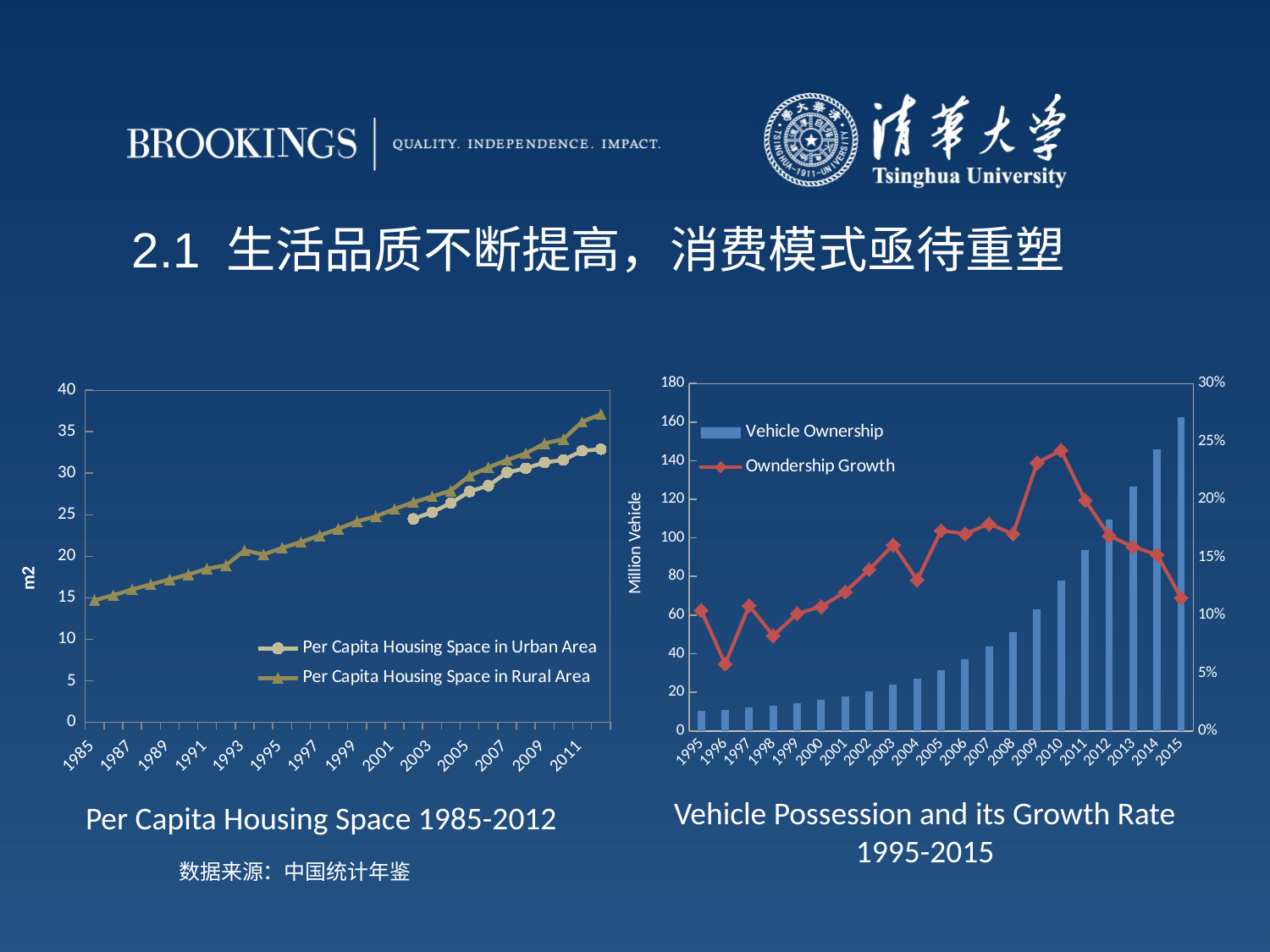
On the left chart, Per Capita Housing Space 1985-2012, how many series does the legend list? 2 On the right chart, Vehicle Possession and its Growth Rate 1995-2015, is the Vehicle Ownership value for 2015 greater or less than 140? greater On the left chart, Per Capita Housing Space 1985-2012, what unit is shown on the y axis? m2 On the right chart, Vehicle Possession and its Growth Rate 1995-2015, in which year is Ownership Growth lowest? 1996 On the right chart, Vehicle Possession and its Growth Rate 1995-2015, in which year is Ownership Growth highest? 2010 On the right chart, Vehicle Possession and its Growth Rate 1995-2015, how many series does the legend list? 2 On the left chart, Per Capita Housing Space 1985-2012, does the rural housing space rise or fall from 1985 to 2012? Rise On the left chart, Per Capita Housing Space 1985-2012, which series is higher in 2012, urban or rural? Per Capita Housing Space in Rural Area On the left chart, Per Capita Housing Space 1985-2012, what kind of chart is it? Line chart On the right chart, Vehicle Possession and its Growth Rate 1995-2015, in which year is Vehicle Ownership highest? 2015 On the left chart, Per Capita Housing Space 1985-2012, is the urban value for 2012 greater or less than 30? greater On the left chart, Per Capita Housing Space 1985-2012, is the rural value for 2012 greater or less than 35? greater